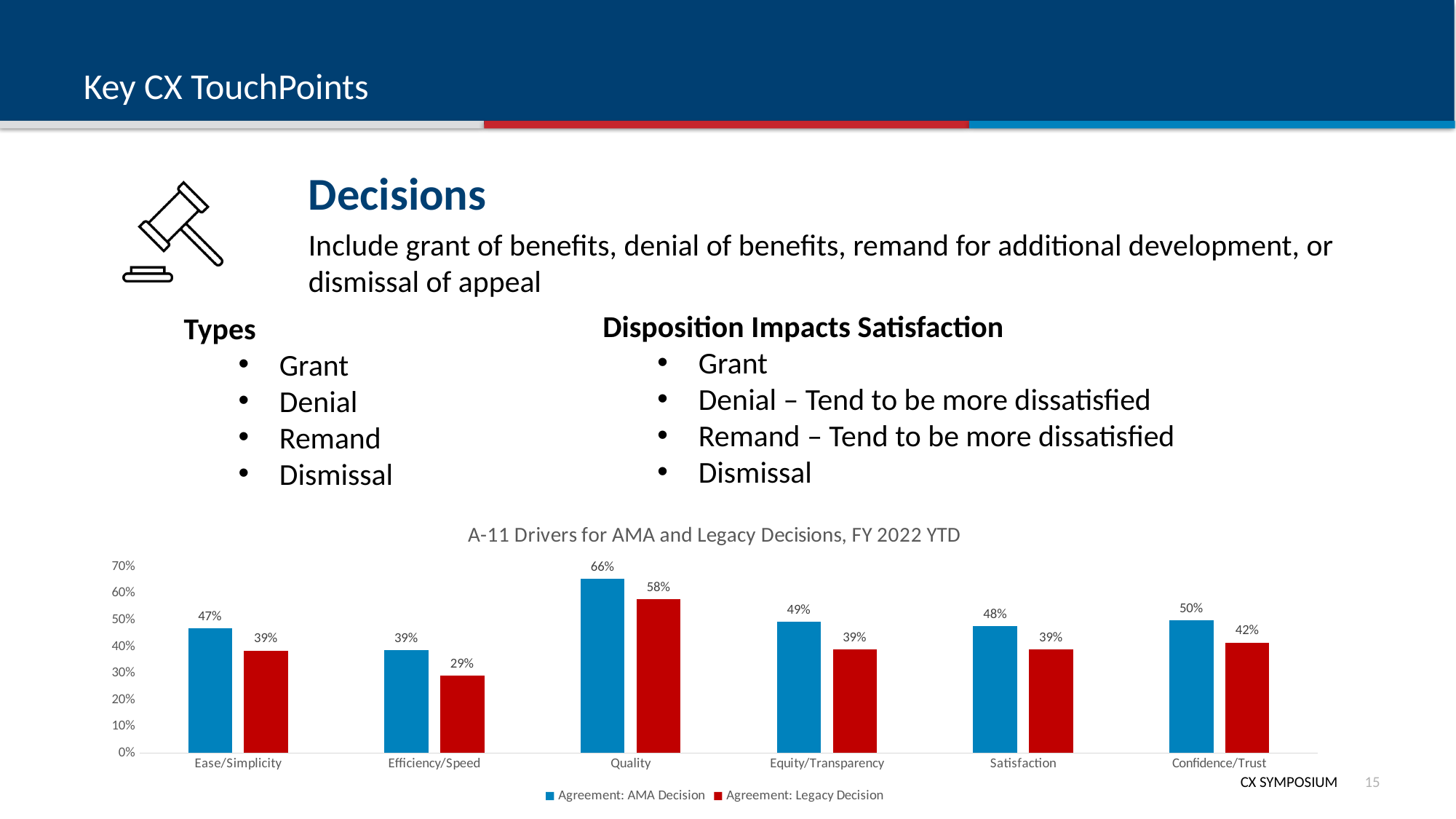
What is the Agreement: Legacy Decision value for Efficiency/Speed? 29% How many categories are shown on the x axis of the chart? 6 Which is larger for Satisfaction: the Agreement: AMA Decision value or the Agreement: Legacy Decision value? Agreement: AMA Decision What is the Agreement: Legacy Decision value for Confidence/Trust? 42% What kind of chart is shown on the slide? Bar chart What is the difference between the AMA Decision and Legacy Decision values for Equity/Transparency? 10% What is the Agreement: AMA Decision value for Quality? 66% How many series does the chart legend list? 2 Which category has the lowest Agreement: Legacy Decision value? Efficiency/Speed Which category has the highest Agreement: AMA Decision value? Quality Is the Agreement: AMA Decision value for Ease/Simplicity greater or less than 40%? greater What is the title of the chart? A-11 Drivers for AMA and Legacy Decisions, FY 2022 YTD